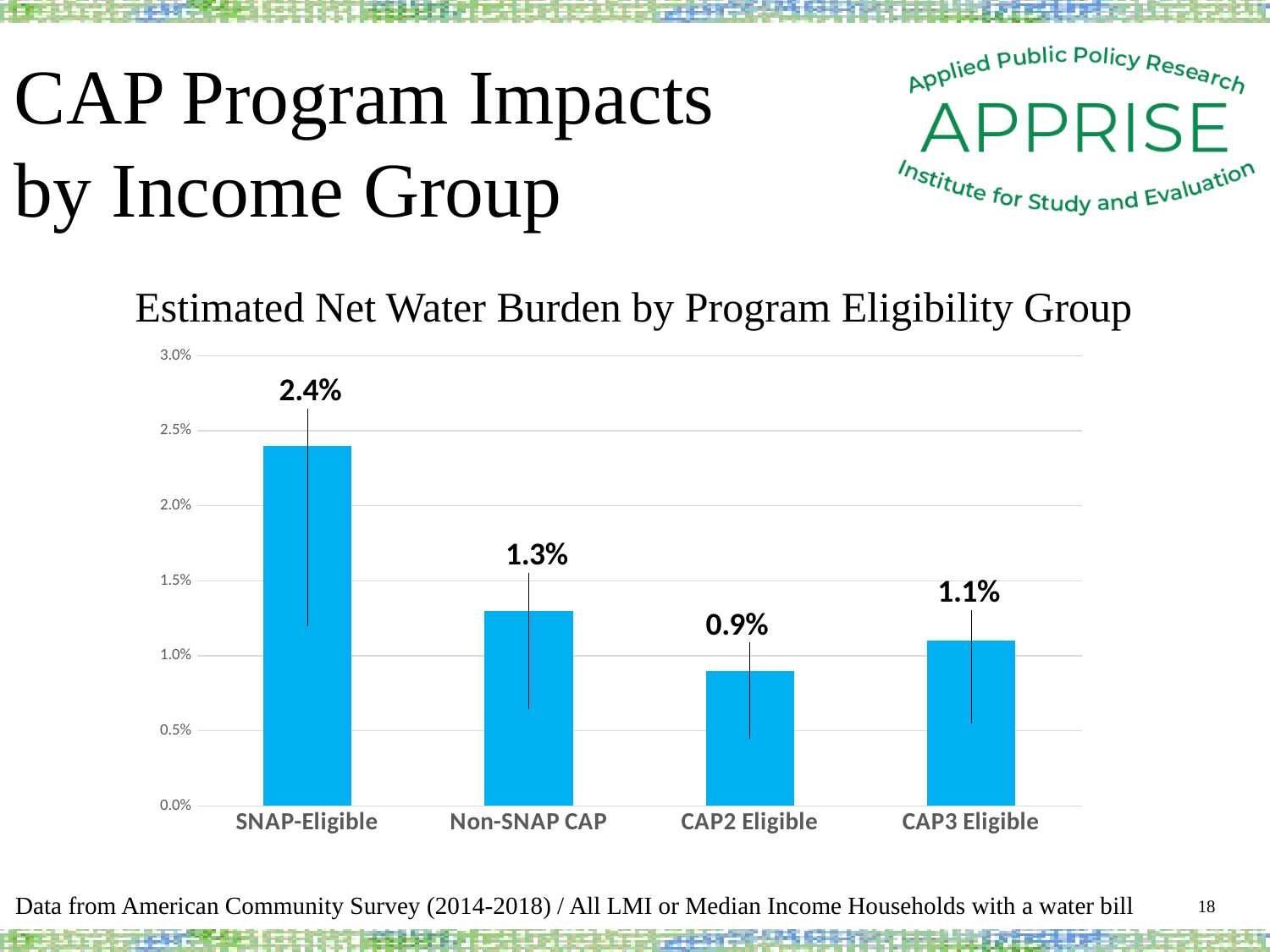
What is the estimated net water burden for the Non-SNAP CAP group? 1.3% What is the difference in estimated net water burden between the SNAP-Eligible and Non-SNAP CAP groups? 1.1% What is the estimated net water burden for the CAP3 Eligible group? 1.1% What is the title of the chart? Estimated Net Water Burden by Program Eligibility Group What type of chart is shown on the slide? Bar chart Which eligibility group has the highest estimated net water burden? SNAP-Eligible What is the estimated net water burden for the SNAP-Eligible group? 2.4% Which has a larger estimated net water burden, CAP2 Eligible or CAP3 Eligible? CAP3 Eligible How many eligibility groups are shown in the chart? 4 Which eligibility group has the lowest estimated net water burden? CAP2 Eligible Is the value for SNAP-Eligible greater or less than 2.0%? greater What is the estimated net water burden for the CAP2 Eligible group? 0.9%